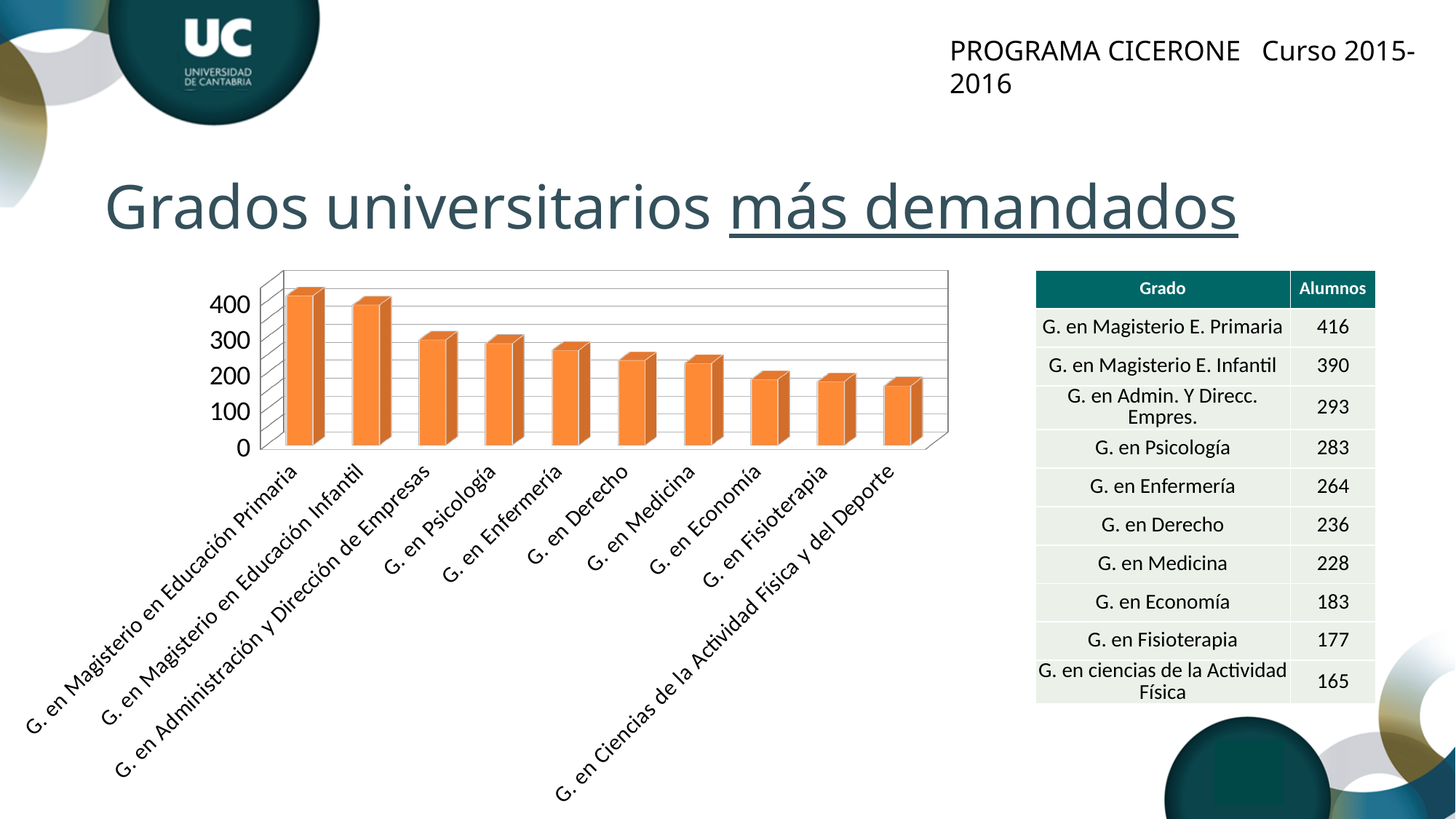
Is the value for G. en Magisterio en Educación Primaria greater or less than 400? greater Which degree has the lowest bar in the chart? G. en Ciencias de la Actividad Física y del Deporte Which bar is taller, G. en Enfermería or G. en Medicina? G. en Enfermería What kind of chart is shown on the slide? bar chart Which degree has the highest bar in the chart? G. en Magisterio en Educación Primaria Do the bar values rise or fall from left to right along the x axis? fall How many degree programmes (bars) are shown in the chart? 10 According to the table next to the chart, how many students (Alumnos) does G. en Derecho have? 236 What is the title of the slide containing the chart? Grados universitarios más demandados Is the value for G. en Economía greater or less than 200? less Using the values in the table, what is the difference in students between G. en Magisterio E. Primaria and G. en Magisterio E. Infantil? 26 Is the value for G. en Psicología greater or less than 200? greater